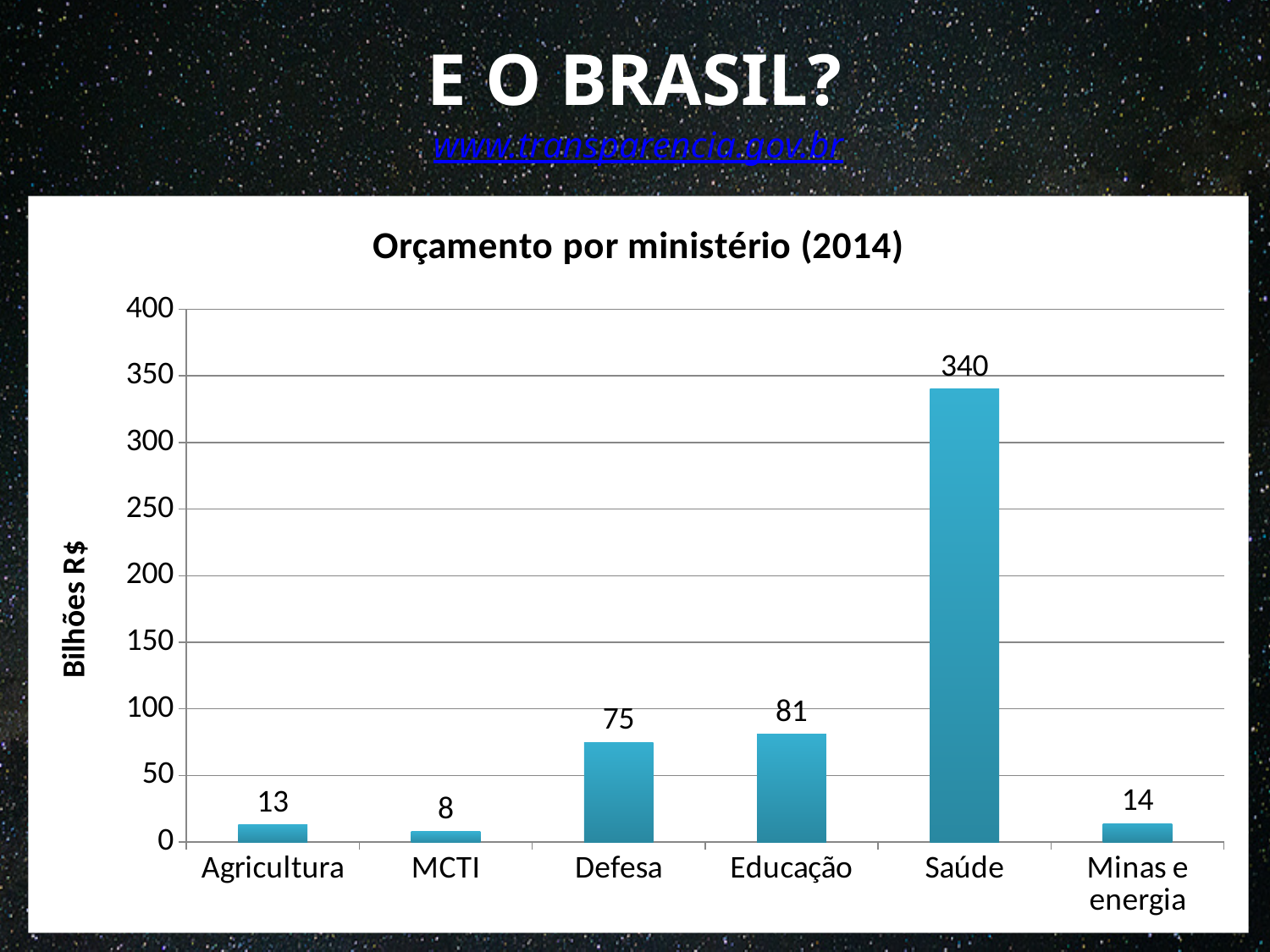
Which ministry has the highest budget? Saúde Is the value for Saúde greater or less than 300? greater What is the title of the chart? Orçamento por ministério (2014) Which ministry has the lowest budget? MCTI What is the difference between the budgets of Minas e energia and Agricultura? 1 What is the budget value for Saúde? 340 What is the budget value for Educação? 81 What is the budget value for MCTI? 8 Which has a larger budget, Defesa or Educação? Educação How many ministries are shown on the chart? 6 What is the difference between the budgets of Saúde and Educação? 259 What kind of chart is shown on the slide? Bar chart